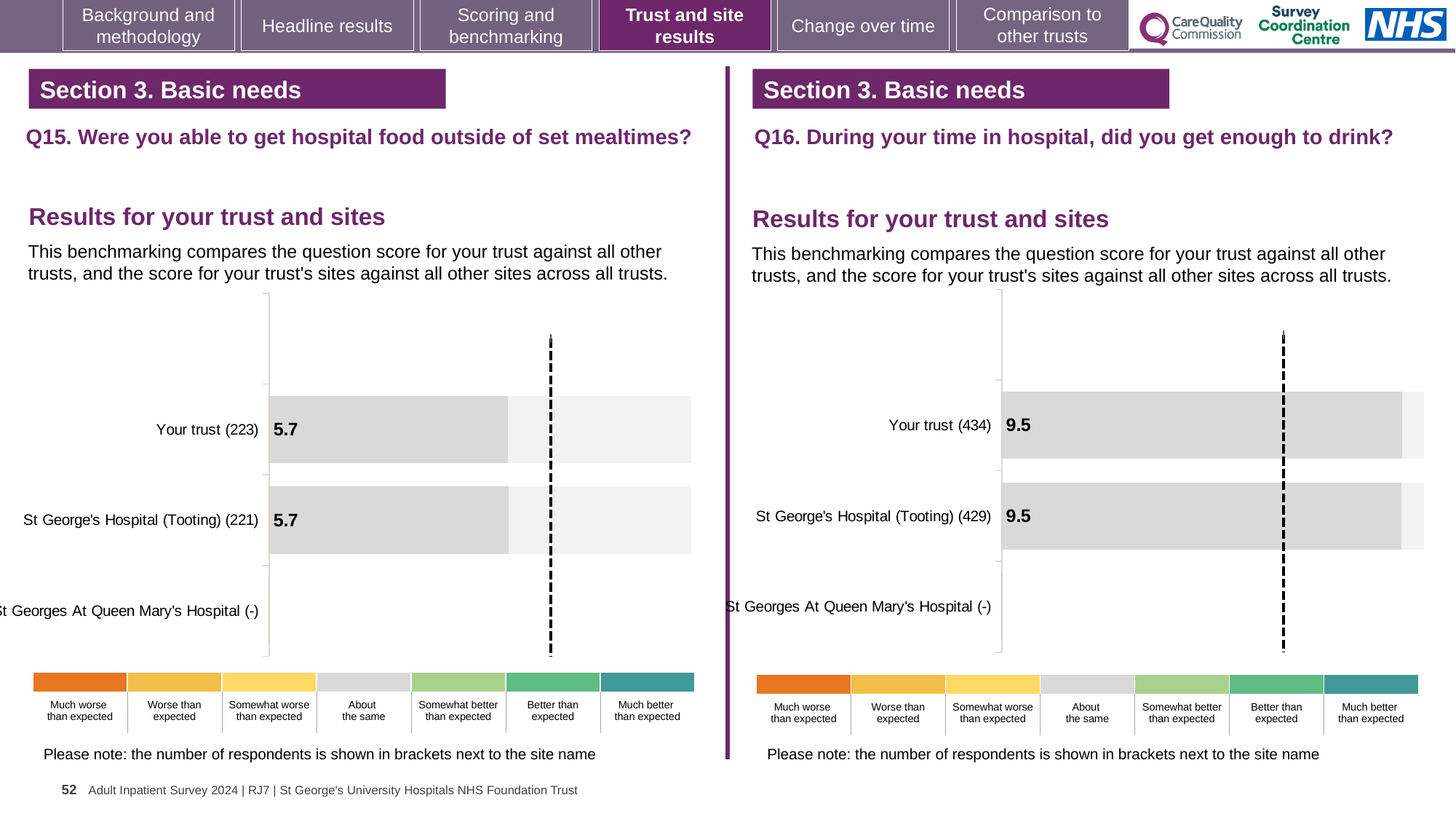
What is the question text shown above the chart on the right? Q16. During your time in hospital, did you get enough to drink? In the Q15 chart on the left, what is the score for Your trust (223)? 5.7 What kind of chart is the Q16 chart on the right? Bar chart In the Q16 chart on the right, what is the difference between the score for Your trust and the score for St George's Hospital (Tooting)? 0 In the Q16 chart on the right, what is the score for Your trust (434)? 9.5 In the Q16 chart on the right, how many respondents are shown in brackets for St George's Hospital (Tooting)? 429 In the Q16 chart on the right, what is the score for St George's Hospital (Tooting) (429)? 9.5 In the Q15 chart on the left, what is the difference between the score for Your trust and the score for St George's Hospital (Tooting)? 0 How many categories are listed on the vertical axis of the Q16 chart on the right? 3 In the Q15 chart on the left, what is the score for St George's Hospital (Tooting) (221)? 5.7 In the Q15 chart on the left, how many respondents are shown in brackets for Your trust? 223 How many categories are listed on the vertical axis of the Q15 chart on the left? 3